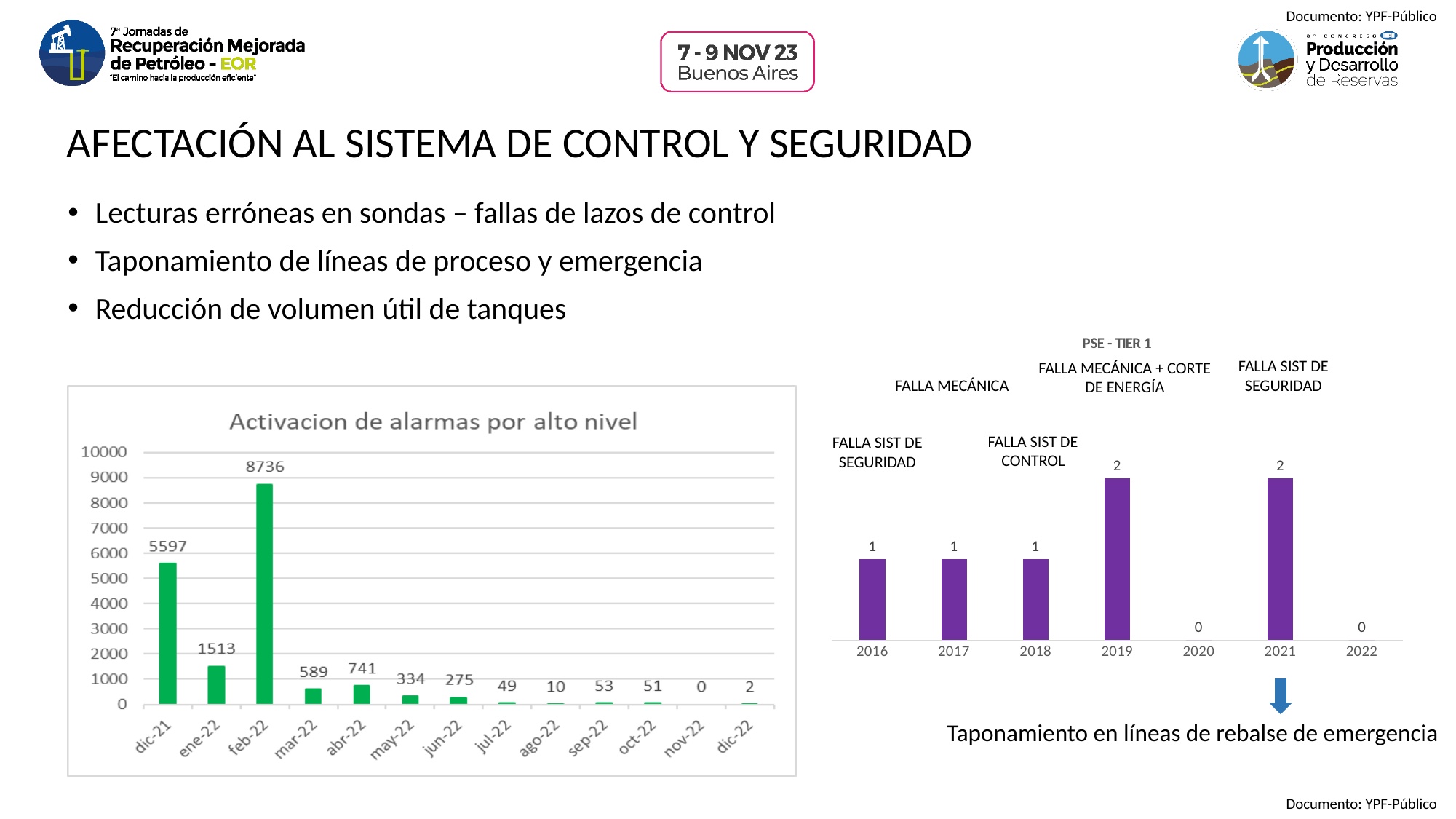
What kind of chart is 'Activacion de alarmas por alto nivel'? bar chart How many years are shown on the x axis of the 'PSE - TIER 1' chart? 7 In the 'Activacion de alarmas por alto nivel' chart, which month has the highest value? feb-22 In the 'Activacion de alarmas por alto nivel' chart, what is the value for feb-22? 8736 How many months are shown on the x axis of the 'Activacion de alarmas por alto nivel' chart? 13 In the 'PSE - TIER 1' chart, what is the value for 2020? 0 In the 'Activacion de alarmas por alto nivel' chart, what is the difference between the values for feb-22 and dic-21? 3139 In the 'Activacion de alarmas por alto nivel' chart, which month has the lowest value? nov-22 In the 'Activacion de alarmas por alto nivel' chart, which is larger, the value for mar-22 or abr-22? abr-22 In the 'PSE - TIER 1' chart, what is the value for 2019? 2 In the 'PSE - TIER 1' chart, what is the total of the values for 2016, 2017 and 2018? 3 In the 'Activacion de alarmas por alto nivel' chart, what is the value for dic-21? 5597